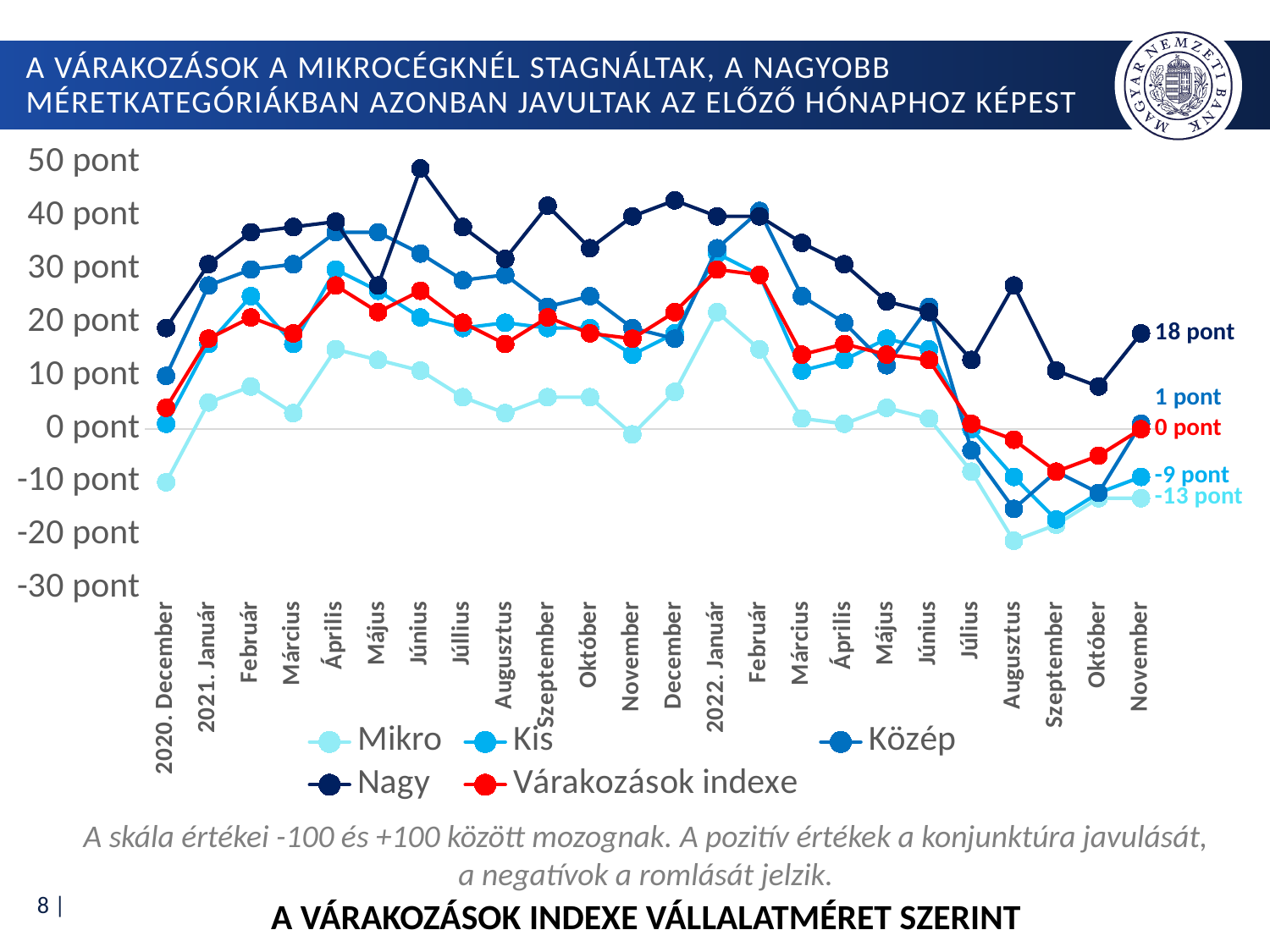
What is the value of the Nagy series in November 2022? 18 pont What is the value of the Várakozások indexe series in November 2022? 0 pont Which series has the lowest value in November 2022? Mikro What kind of chart is shown on the slide? line chart What is the difference between the Nagy and Mikro values in November 2022? 31 pont What is the value of the Mikro series in November 2022? -13 pont Which series has the highest value in November 2022? Nagy In November 2022, which is larger: the Közép value or the Kis value? Közép How many series does the legend list? 5 What is the value of the Kis series in November 2022? -9 pont Is the value for Nagy in June 2021 greater or less than 40 pont? greater Does the Nagy series rise or fall from June 2022 to July 2022? fall